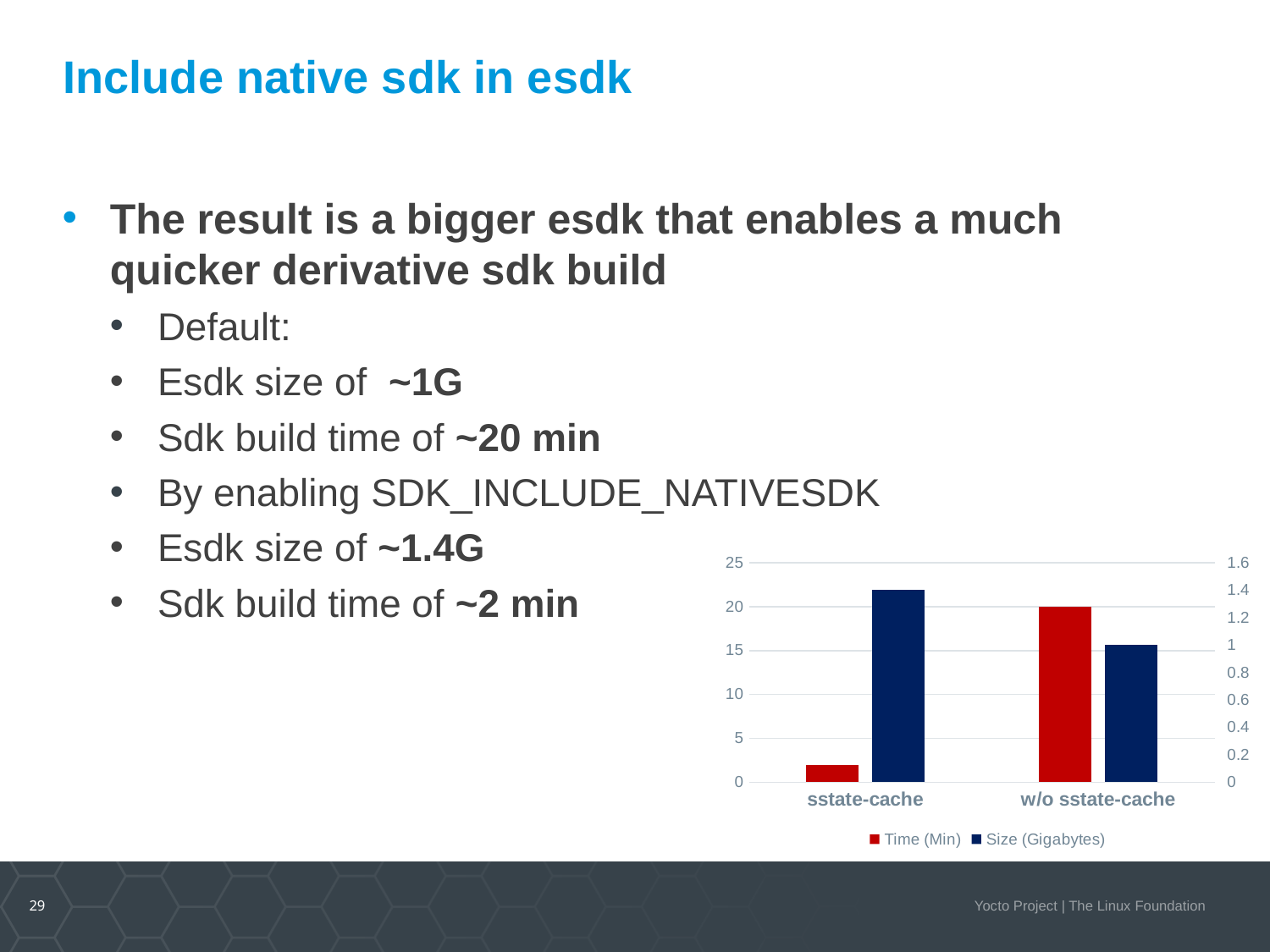
Is the Time (Min) value for w/o sstate-cache greater or less than 15? greater Which category has the higher Time (Min) value in the chart? w/o sstate-cache Is the Size (Gigabytes) value for w/o sstate-cache greater or less than 0.8? greater How many categories are shown on the x axis of the chart? 2 What is the highest tick value shown on the right-hand axis of the chart? 1.6 Which category has the larger Size (Gigabytes) value in the chart? sstate-cache Which category has the lower Time (Min) value in the chart? sstate-cache Is the Time (Min) value for sstate-cache greater or less than 5? less How many series does the chart's legend list? 2 What kind of chart is shown on the slide? bar chart Which series in the chart is drawn in red? Time (Min)